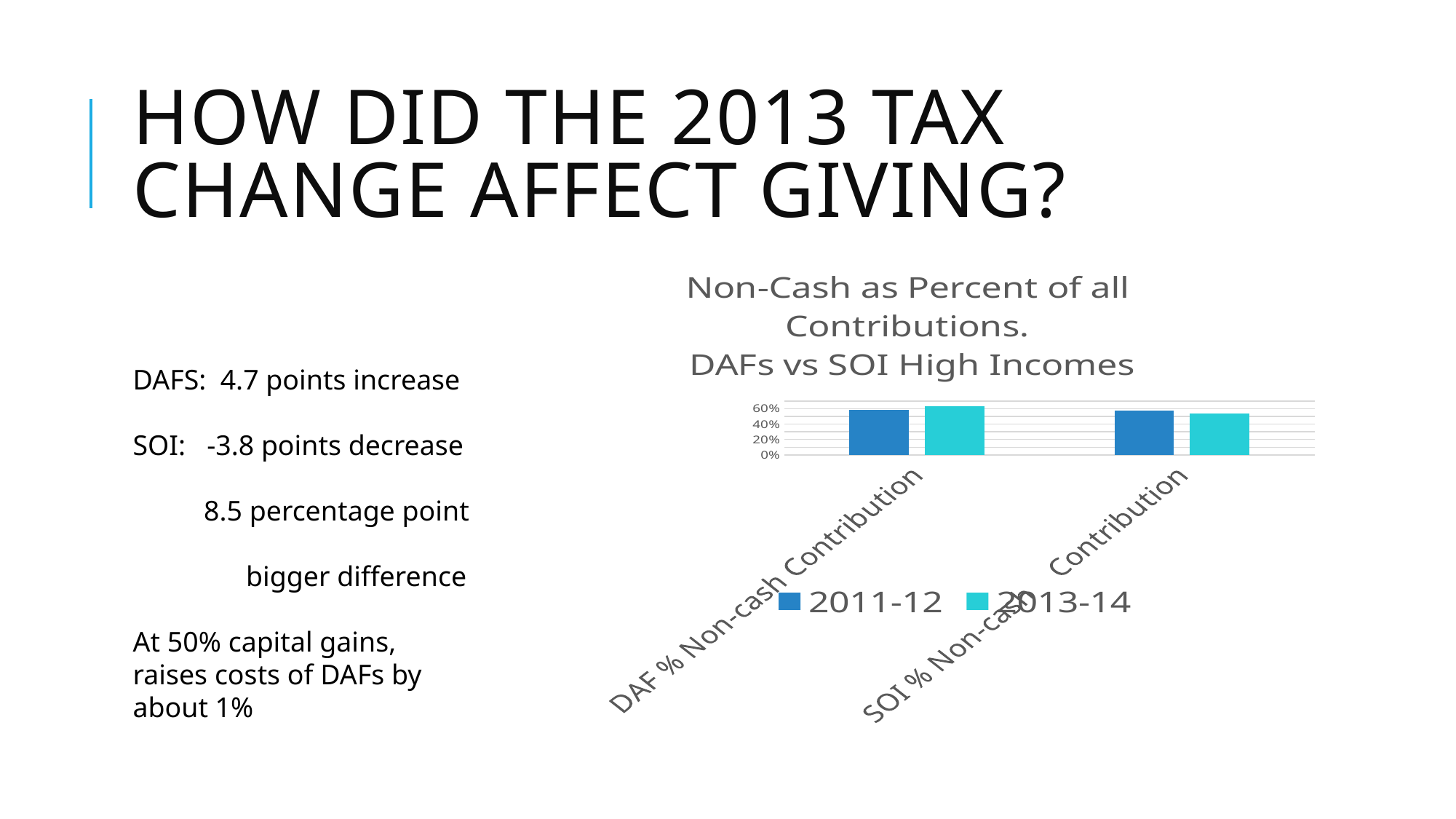
For SOI % Non-cash Contribution, which series has the larger value, 2011-12 or 2013-14? 2011-12 What is the title of the chart? Non-Cash as Percent of all Contributions. DAFs vs SOI High Incomes How many categories are shown on the x axis of the chart? 2 Which two series are listed in the chart legend? 2011-12 and 2013-14 For DAF % Non-cash Contribution, which series has the larger value, 2011-12 or 2013-14? 2013-14 Did the DAF % Non-cash Contribution value rise or fall from 2011-12 to 2013-14? rise Did the SOI % Non-cash Contribution value rise or fall from 2011-12 to 2013-14? fall Is the 2013-14 value for SOI % Non-cash Contribution greater or less than 40%? greater How many series does the chart legend list? 2 Is the 2011-12 value for DAF % Non-cash Contribution greater or less than 20%? greater What kind of chart is shown on the slide? bar chart Is the 2013-14 value for DAF % Non-cash Contribution greater or less than 40%? greater